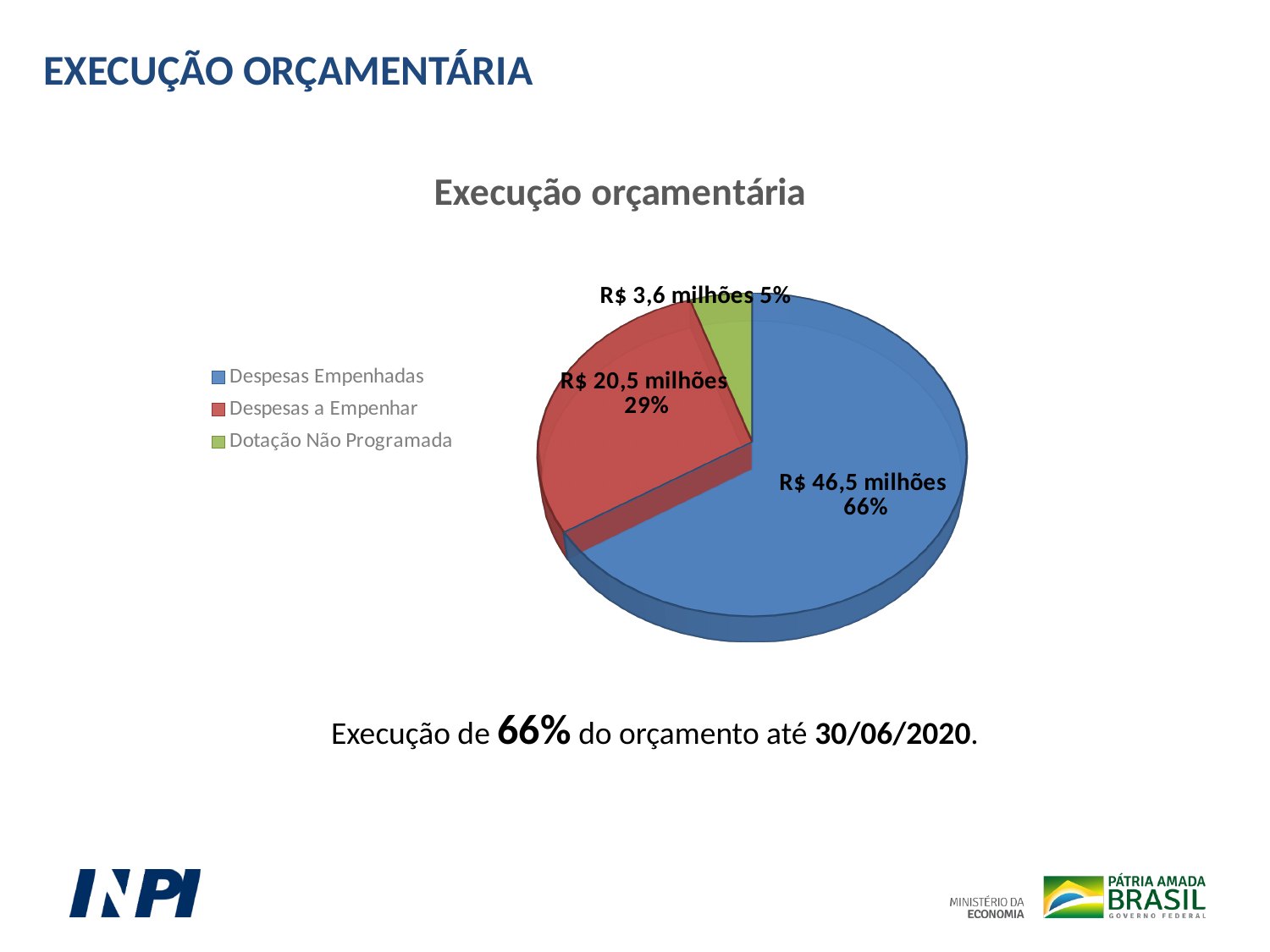
What value is shown for Despesas Empenhadas? R$ 46,5 milhões How many slices does the pie chart have? 3 Which category has the largest slice? Despesas Empenhadas What value is shown for Despesas a Empenhar? R$ 20,5 milhões What kind of chart is shown on the slide? Pie chart Which category has the smallest slice? Dotação Não Programada What share of the pie does Despesas Empenhadas represent? 66% What share of the pie does Despesas a Empenhar represent? 29% How many entries does the legend list? 3 What is the title of the chart? Execução orçamentária What value is shown for Dotação Não Programada? R$ 3,6 milhões Which colour represents Despesas a Empenhar in the chart? Red